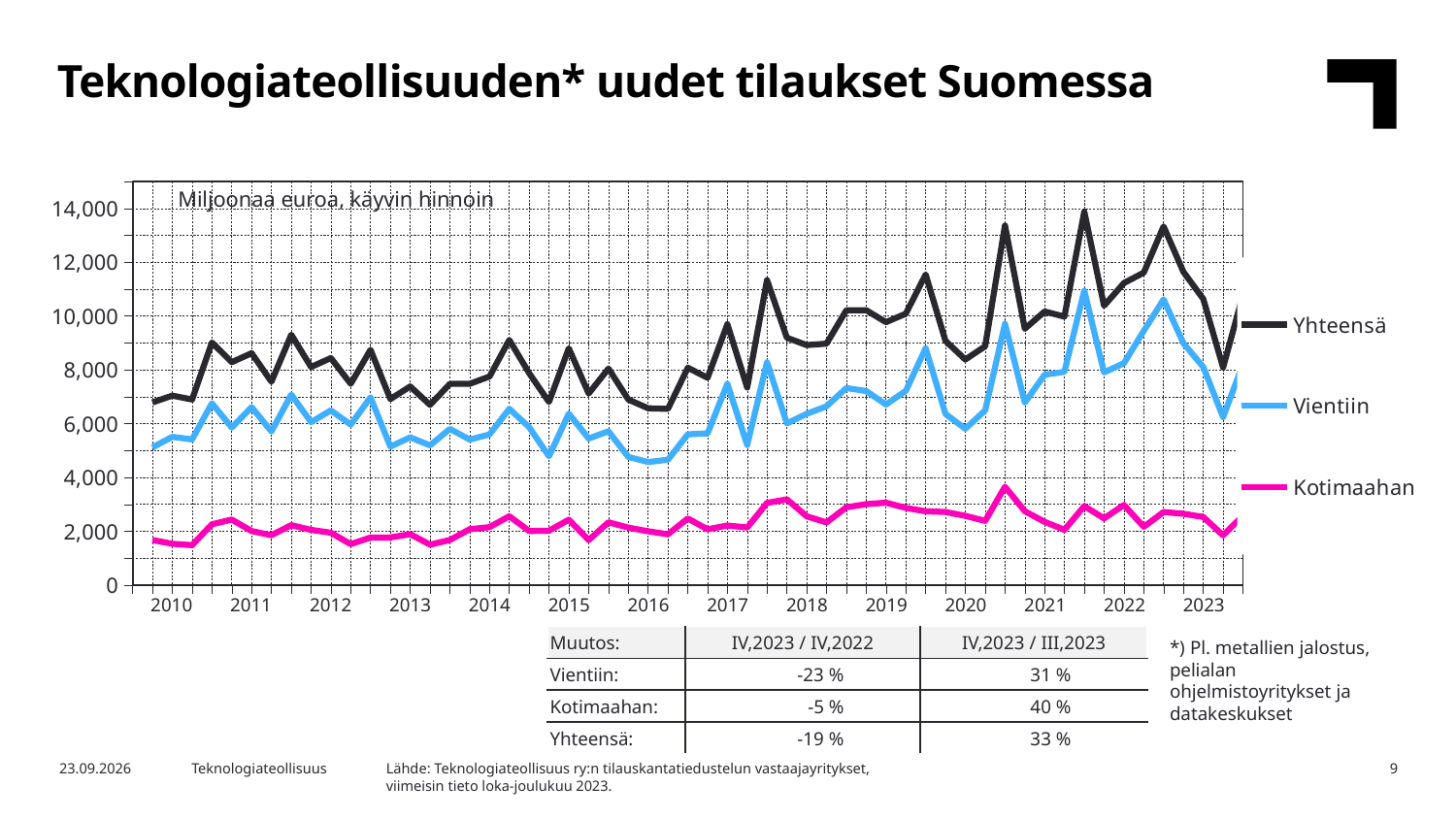
What kind of chart is shown on the slide? line chart Is the value of Kotimaahan at the start of 2010 greater or less than 2,000? less How many series does the legend list? 3 What unit is stated in the label inside the chart area? Miljoonaa euroa, käyvin hinnoin What are the three series named in the legend? Yhteensä, Vientiin, Kotimaahan Is the peak value of the Kotimaahan series greater or less than 4,000? less Does the Yhteensä series overall rise or fall from 2010 to 2023? rise Which series has the highest values throughout the chart? Yhteensä How many year labels are shown on the x axis? 14 Which series has the lowest values throughout the chart? Kotimaahan Is the peak value of the Vientiin series in 2021 greater or less than 10,000? greater Which series is larger in 2019, Vientiin or Kotimaahan? Vientiin